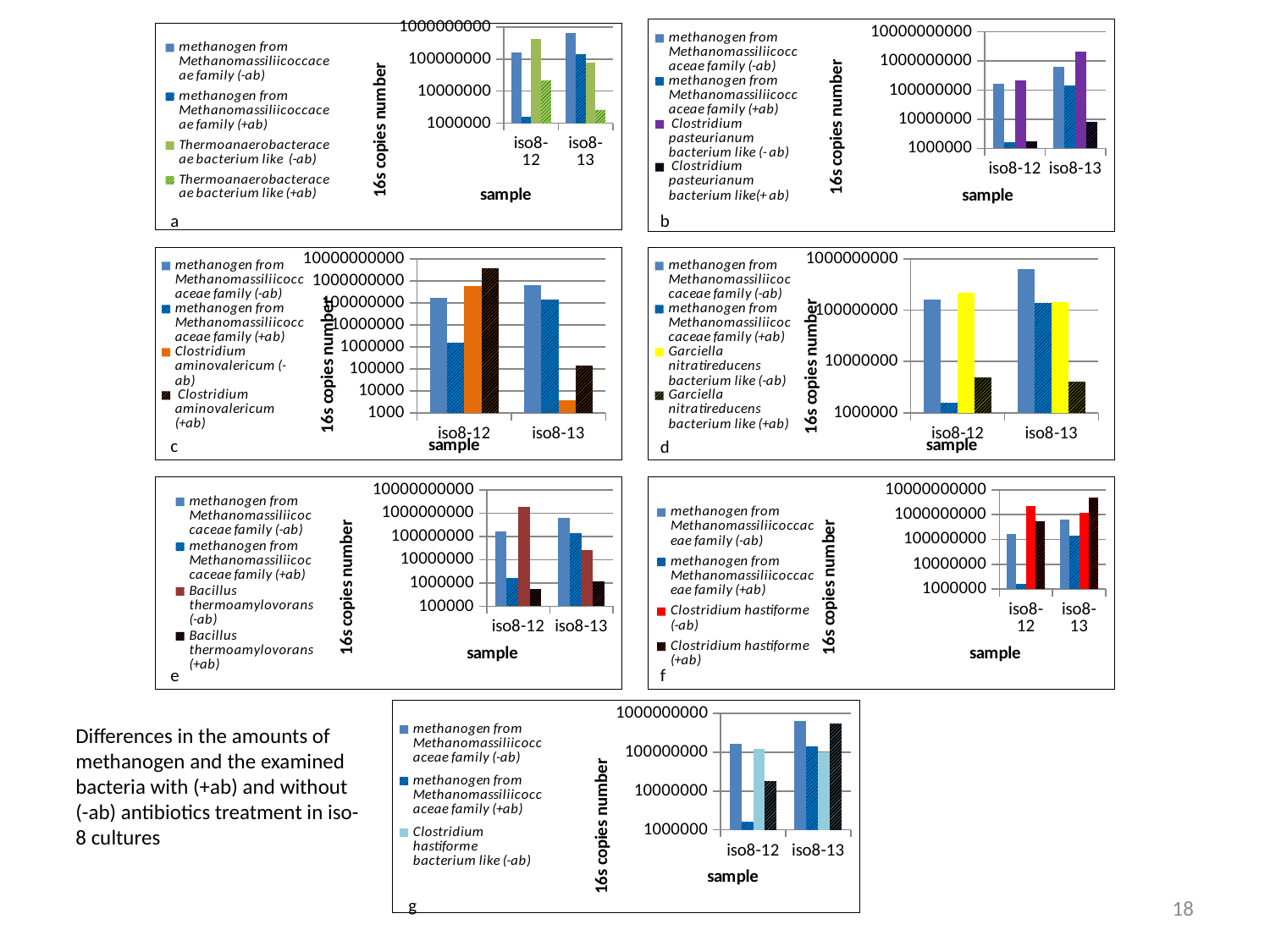
In chart a, which sample has the larger value for methanogen from Methanomassiliicoccaceae family (-ab), iso8-12 or iso8-13? iso8-13 In chart d, is the value for Garciella nitratireducens bacterium like (+ab) in iso8-12 greater or less than 10000000? less What is the y-axis title of chart f? 16s copies number How many sample categories are shown on the x axis of chart b? 2 In chart b, which sample has the larger value for Clostridium pasteurianum bacterium like (-ab), iso8-12 or iso8-13? iso8-13 How many series does the legend of chart g (bottom) list? 3 In chart a, is the value for methanogen from Methanomassiliicoccaceae family (-ab) in iso8-12 greater or less than 100000000? greater In chart e, is the value for Bacillus thermoamylovorans (-ab) in iso8-12 greater or less than 1000000000? greater How many series does the legend of chart c list? 4 What kind of chart is chart a (top left)? bar chart